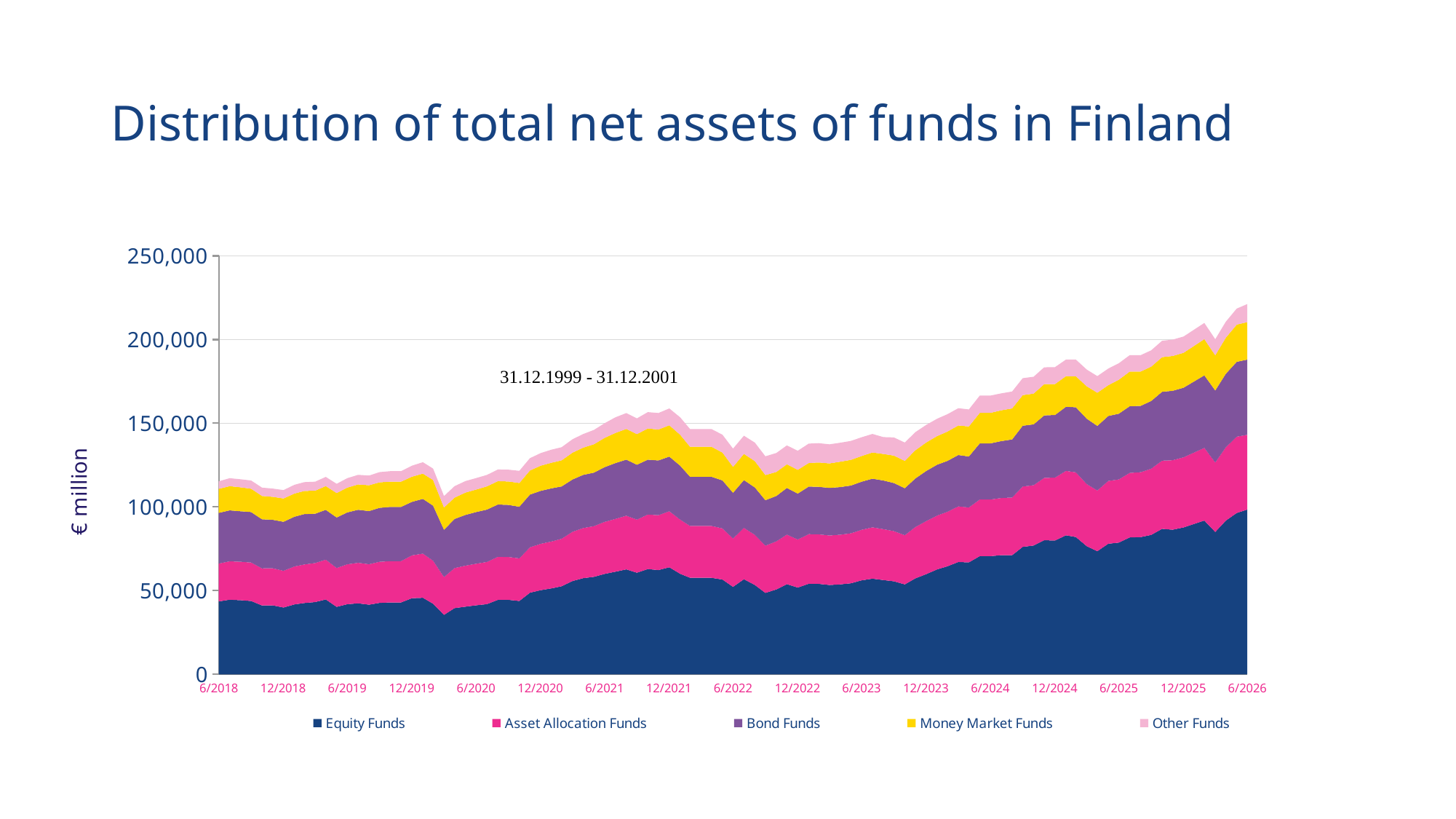
What is the label on the vertical axis? € million How many date labels are shown along the x axis? 17 Does the total net assets value rise or fall overall from 6/2018 to 6/2026? rise Is the total net assets value at 6/2018 greater or less than 100,000? greater Is the total net assets value at 12/2022 greater or less than 150,000? less Which is larger, the total net assets at 6/2026 or at 6/2018? 6/2026 What is the title of the chart? Distribution of total net assets of funds in Finland Is the total net assets value at 12/2021 greater or less than 150,000? greater How many series does the legend list? 5 What kind of chart is shown on the slide? Stacked area chart